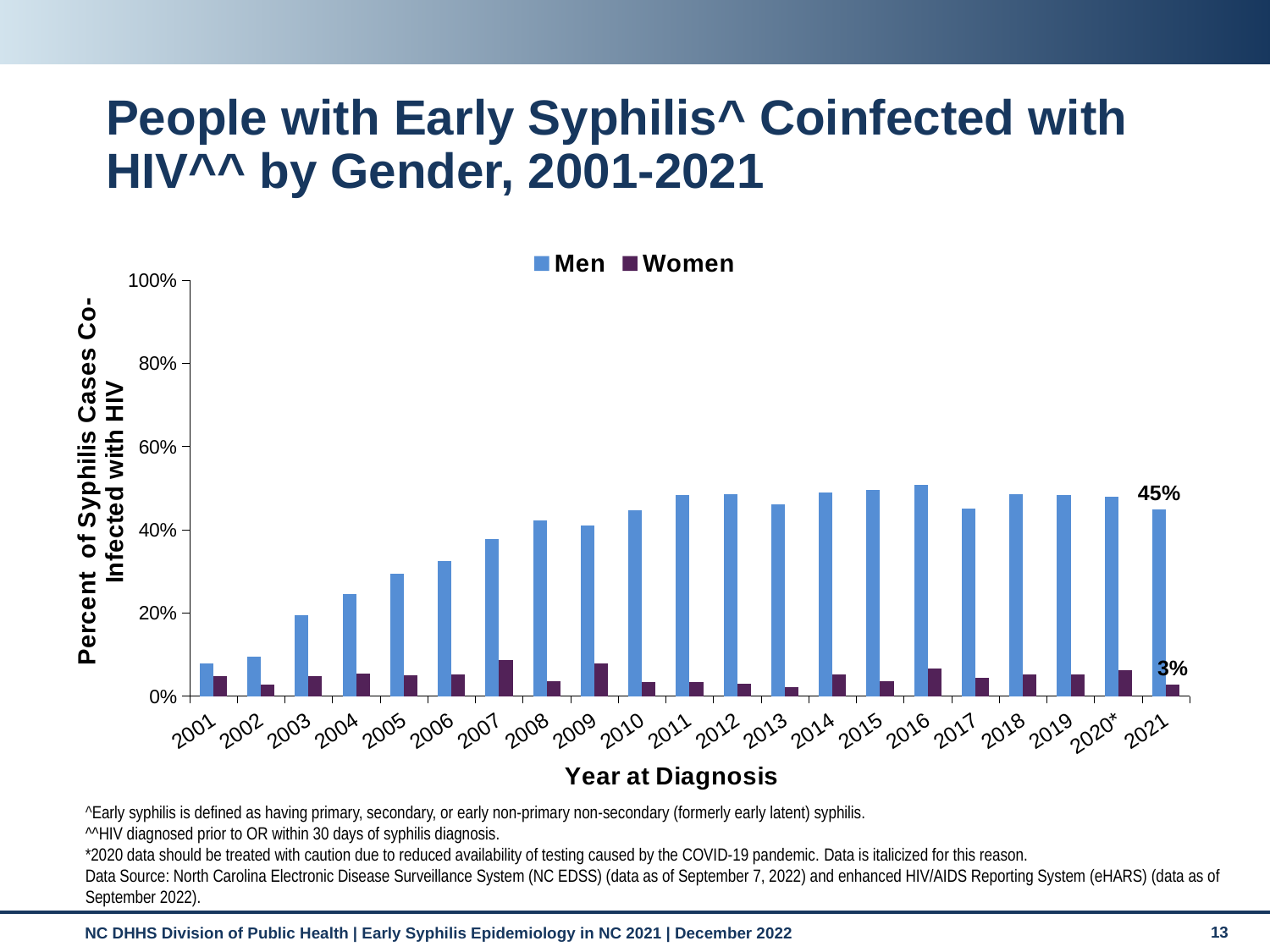
How many series does the legend list? 2 How many years are shown on the x axis? 21 What kind of chart is shown on the slide? Bar chart Is the value for Men in 2005 greater or less than 20%? greater Is the value for Men in 2016 greater or less than 40%? greater Is the value for Men in 2001 greater or less than 20%? less In 2021, which series has the larger value, Men or Women? Men Do the values for Men rise or fall from 2001 to 2011? Rise What is the difference between the Men and Women values in 2021? 42 percentage points What is the value for Women in 2021? 3% What is the value for Men in 2021? 45%